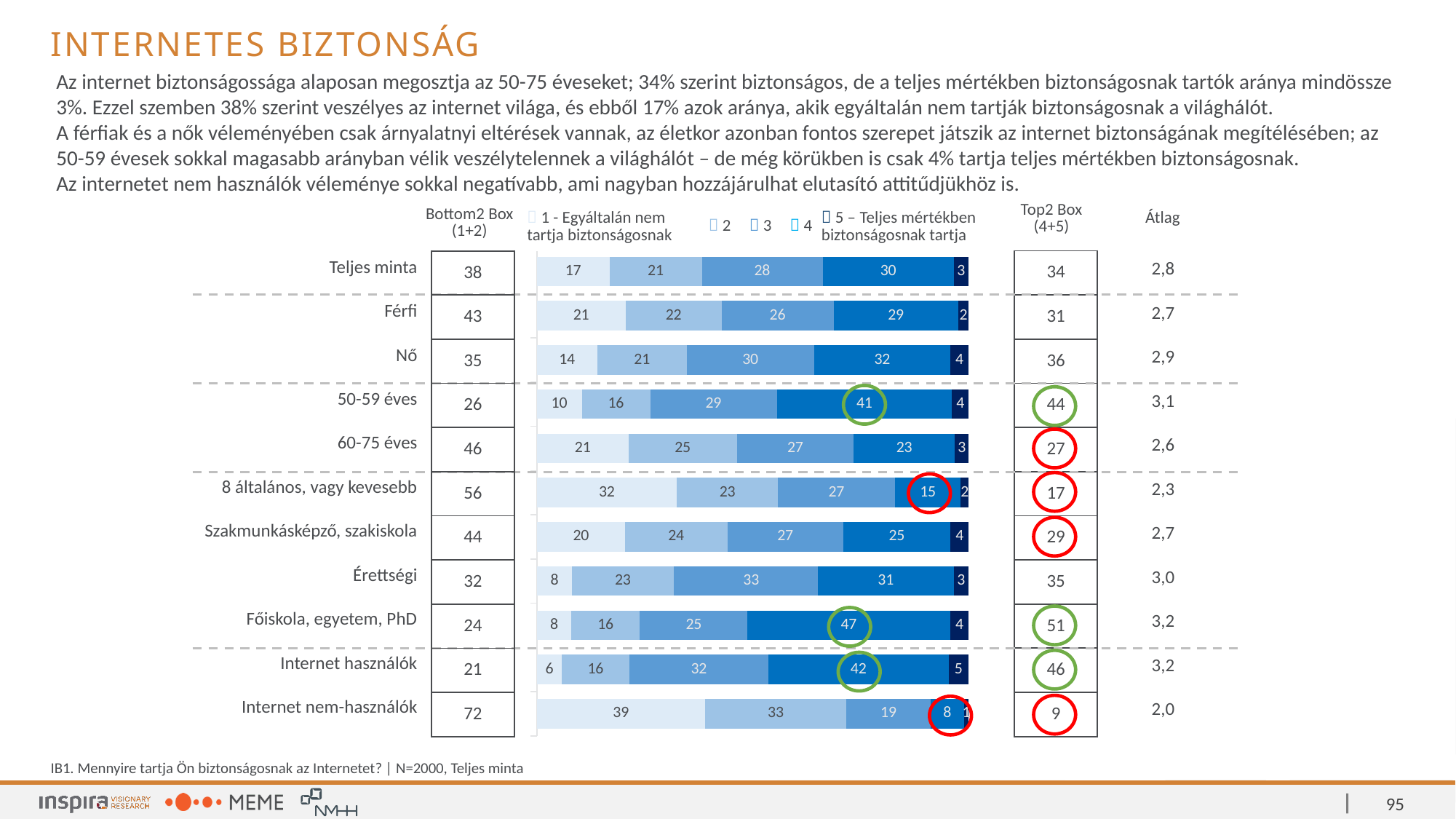
What kind of chart is shown on the slide? Stacked bar chart What is the total of the stacked bar for 'Internet nem-használók'? 100 What is the Top2 Box (4+5) value shown for 'Főiskola, egyetem, PhD'? 51 What is the value for 'Főiskola, egyetem, PhD' in the series '4'? 47 Which category has the highest value in the series '5 – Teljes mértékben biztonságosnak tartja'? Internet használók How many categories are shown in the chart? 11 Which is larger in the series '4': '50-59 éves' or '60-75 éves'? 50-59 éves What is the value for 'Internet nem-használók' in the series '1 - Egyáltalán nem tartja biztonságosnak'? 39 What is the difference between 'Nő' and 'Férfi' in the series '4'? 3 What is the value for 'Teljes minta' in the series '1 - Egyáltalán nem tartja biztonságosnak'? 17 How many series does the legend list? 5 Which category has the lowest value in the series '1 - Egyáltalán nem tartja biztonságosnak'? Internet használók